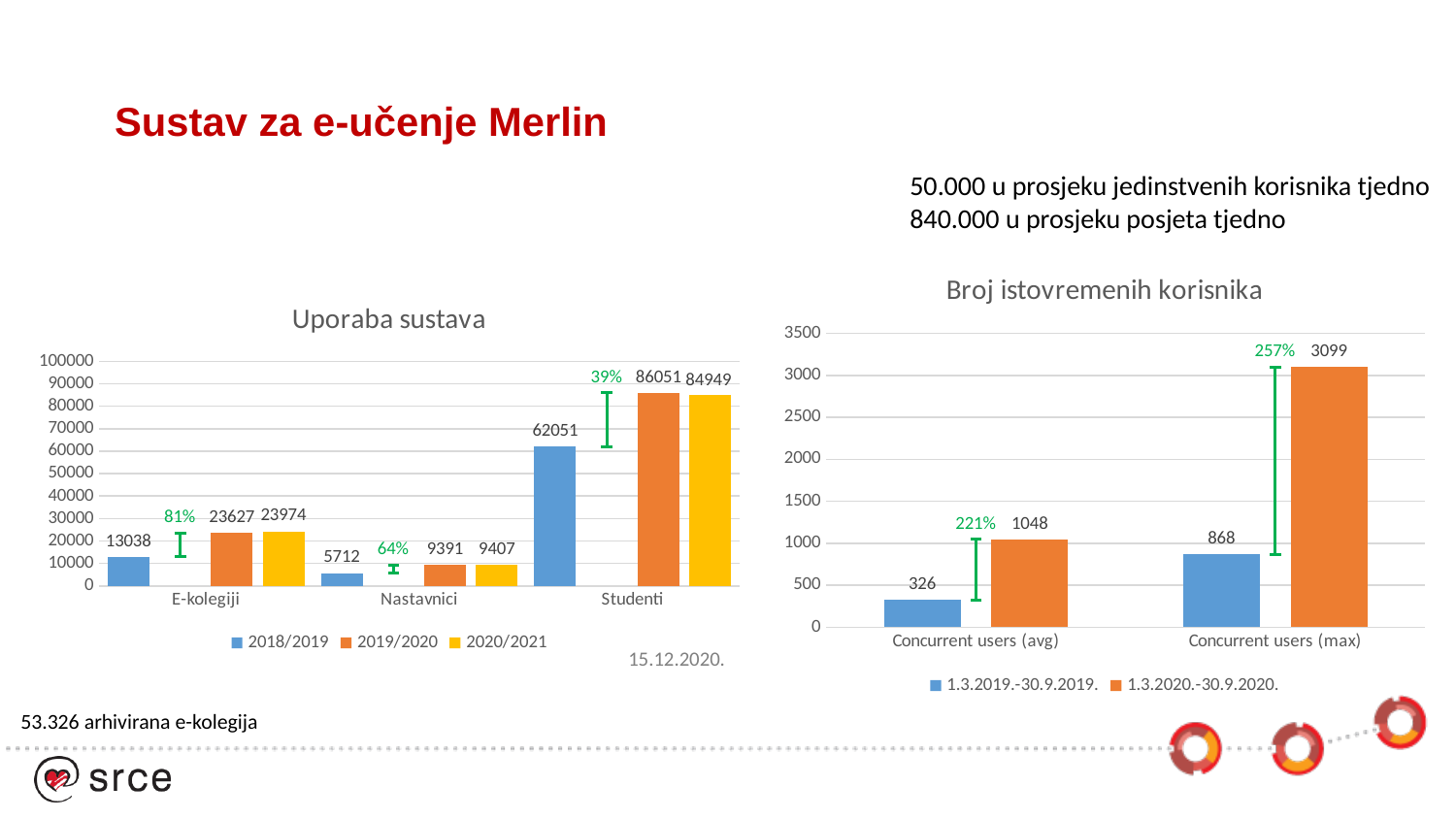
In the 'Uporaba sustava' chart, which is larger for Studenti: the 2019/2020 value or the 2020/2021 value? 2019/2020 In the 'Uporaba sustava' chart, which category has the lowest value in 2018/2019? Nastavnici In the 'Uporaba sustava' chart, what is the value for Nastavnici in 2019/2020? 9391 In the 'Broj istovremenih korisnika' chart, what is the value for Concurrent users (avg) in the 1.3.2019.-30.9.2019. period? 326 In the 'Broj istovremenih korisnika' chart, what percentage increase is shown above the Concurrent users (avg) bars? 221% In the 'Uporaba sustava' chart, what is the difference between the 2019/2020 and 2018/2019 values for E-kolegiji? 10589 What type of chart is 'Broj istovremenih korisnika'? Bar chart In the 'Broj istovremenih korisnika' chart, what is the difference between the two periods for Concurrent users (max)? 2231 In the 'Broj istovremenih korisnika' chart, what is the value for Concurrent users (max) in the 1.3.2020.-30.9.2020. period? 3099 In the 'Uporaba sustava' chart, what is the value for Studenti in 2018/2019? 62051 How many series does the legend of the 'Uporaba sustava' chart list? 3 In the 'Uporaba sustava' chart, what is the value for E-kolegiji in 2020/2021? 23974